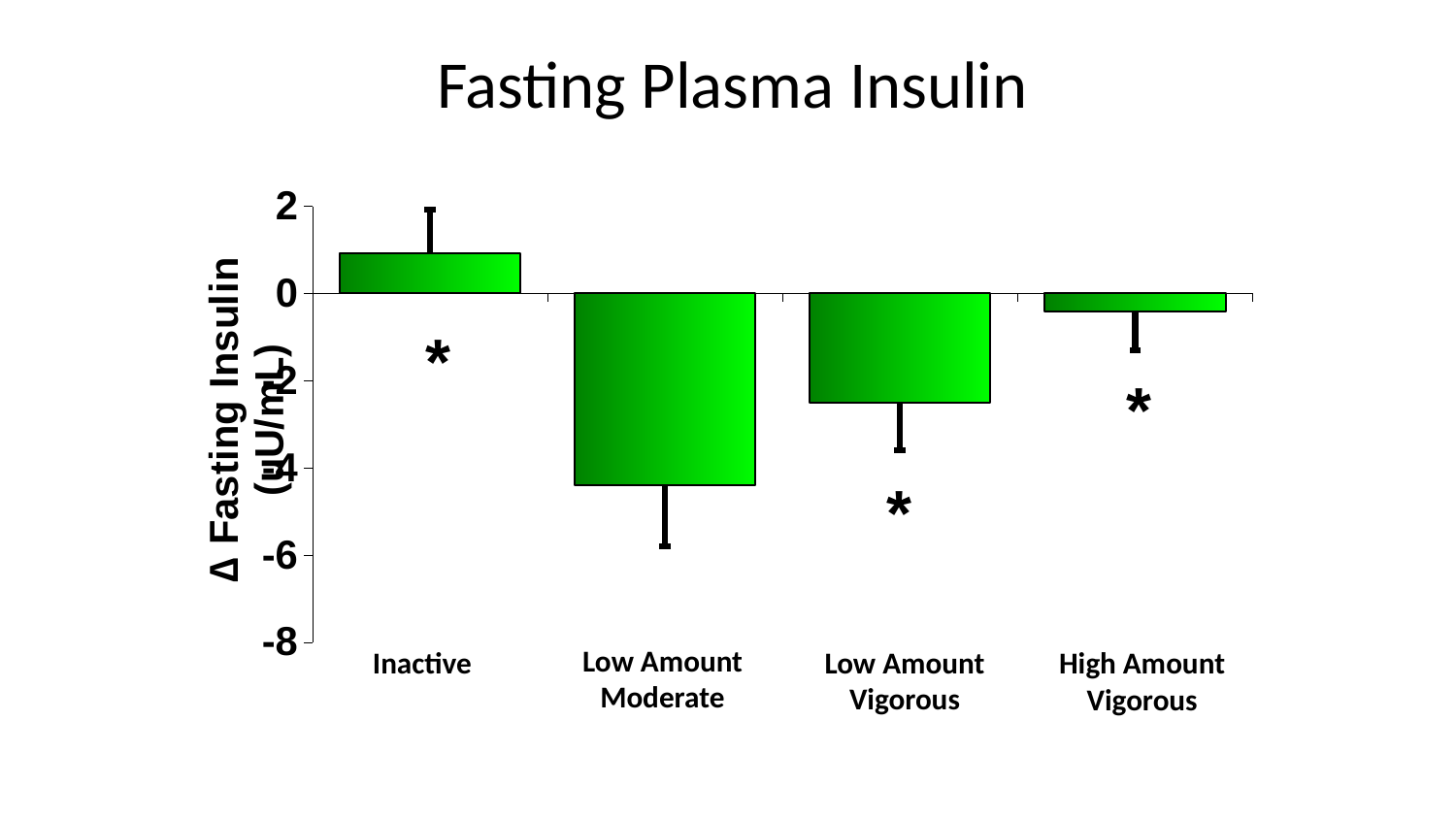
Is the value for Low Amount Vigorous greater or less than -2? less How many categories are shown on the x axis? 4 Is the value for High Amount Vigorous greater or less than -2? greater What kind of chart is shown on the slide? bar chart What is the label of the y axis? Δ Fasting Insulin (μU/mL) Which category has the lowest value? Low Amount Moderate Is the value for Low Amount Moderate greater or less than -4? less Which is larger, the value for High Amount Vigorous or the value for Low Amount Vigorous? High Amount Vigorous What is the title of the chart? Fasting Plasma Insulin Which is larger, the value for Low Amount Moderate or the value for Low Amount Vigorous? Low Amount Vigorous Which category has the highest value? Inactive